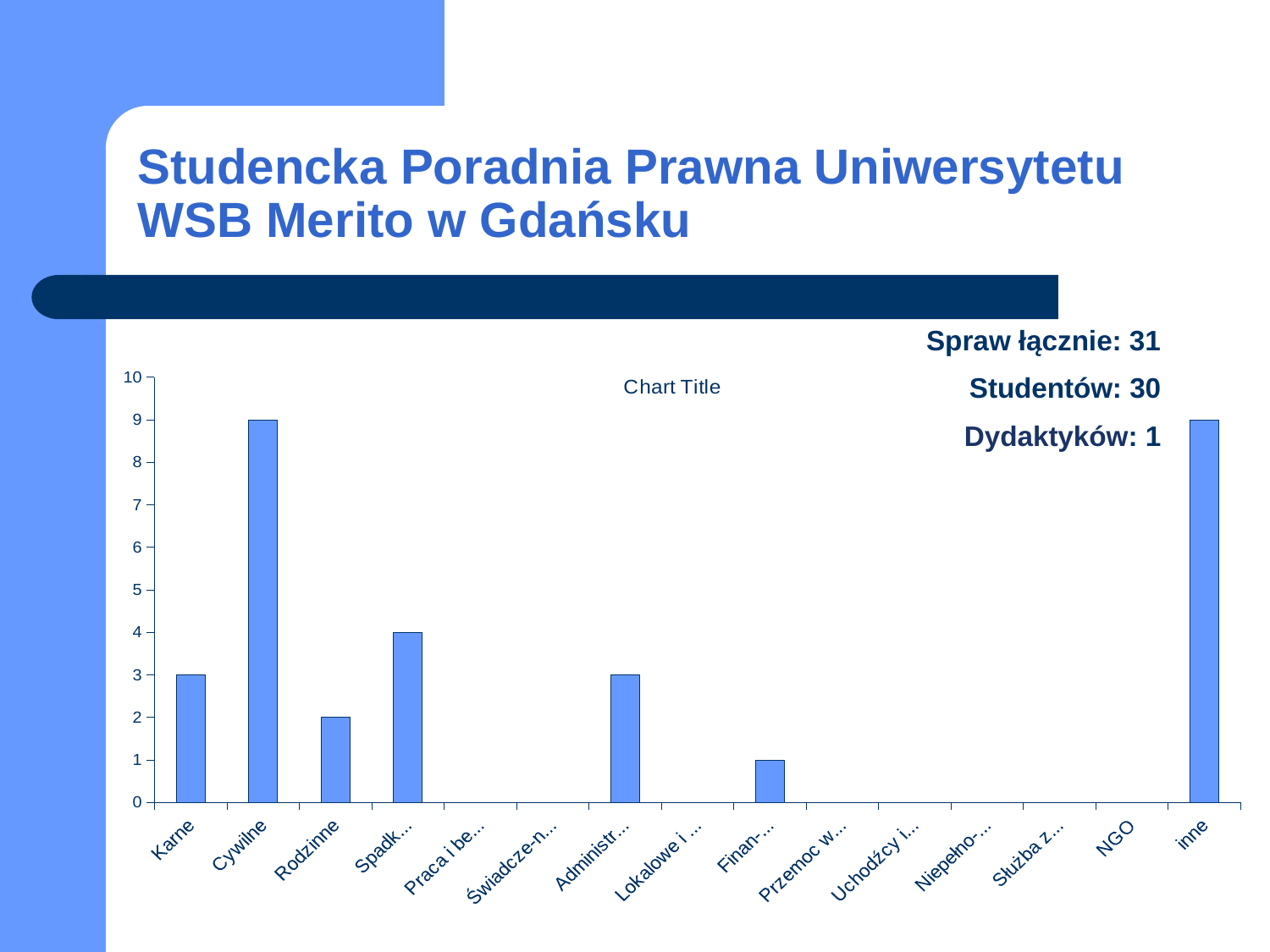
What is the value for Cywilne? 9 What kind of chart is shown on the slide? bar chart Is the value for Cywilne greater or less than 5? greater What is the difference between the values for Cywilne and Karne? 6 Which is larger, the value for Cywilne or the value for Rodzinne? Cywilne How many categories are shown on the x axis of the chart? 15 What is the value for NGO? 0 What is the difference between the values for Karne and Rodzinne? 1 What is the value for Rodzinne? 2 What is the value for inne? 9 What is the value for Karne? 3 What is the title shown on the chart? Chart Title